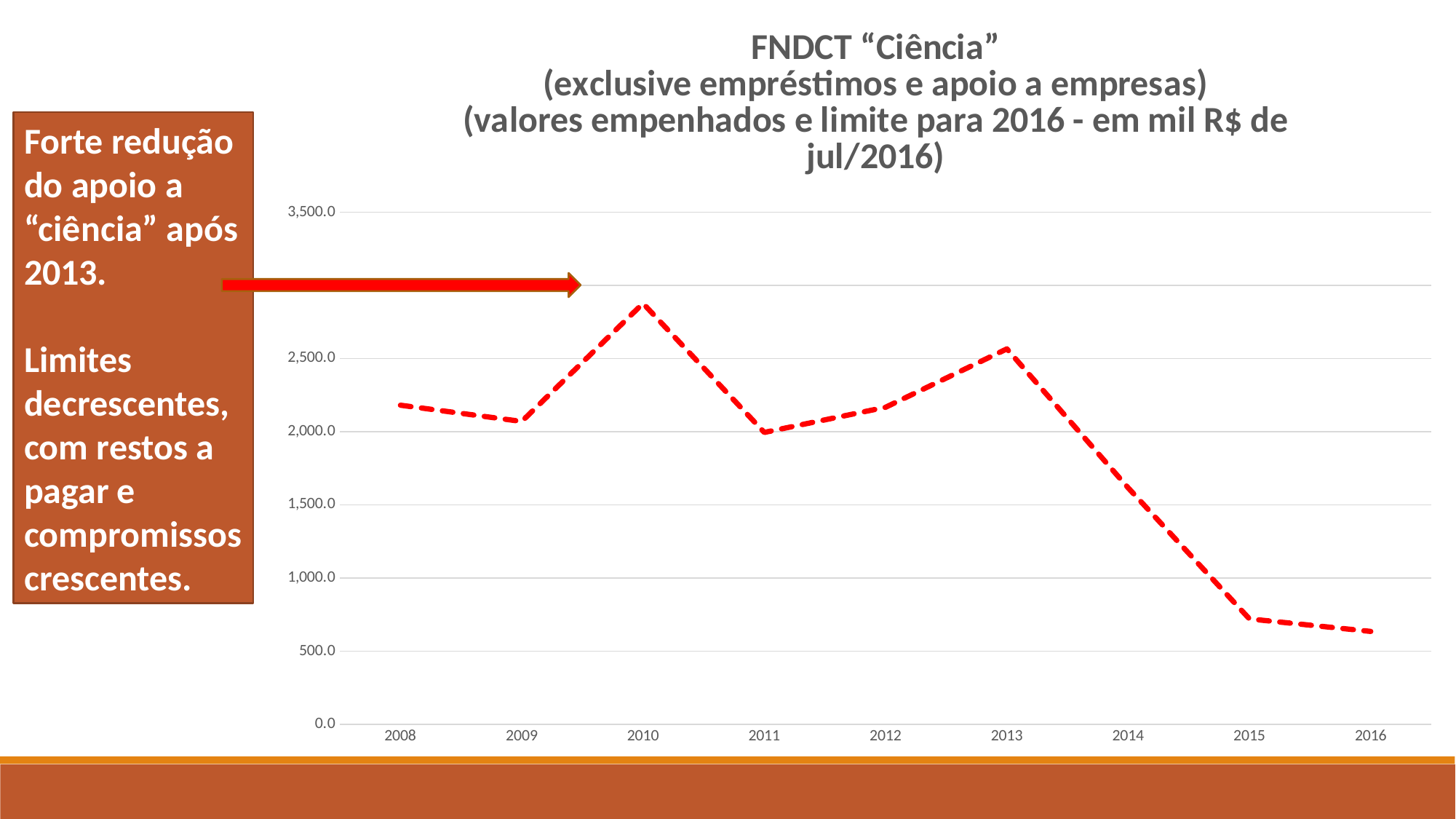
What kind of chart is shown on the slide? line chart Is the value for 2010 greater or less than 2,500? greater Do the values rise or fall from 2013 to 2016? fall What is the first line of the chart's title? FNDCT "Ciência" Which year has the highest value in the chart? 2010 Which year has the larger value, 2014 or 2015? 2014 Which year has the lowest value in the chart? 2016 How many years are plotted along the x axis of the chart? 9 Is the value for 2015 greater or less than 1,000? less Which year has the larger value, 2010 or 2013? 2010 Is the value for 2013 greater or less than 2,000? greater